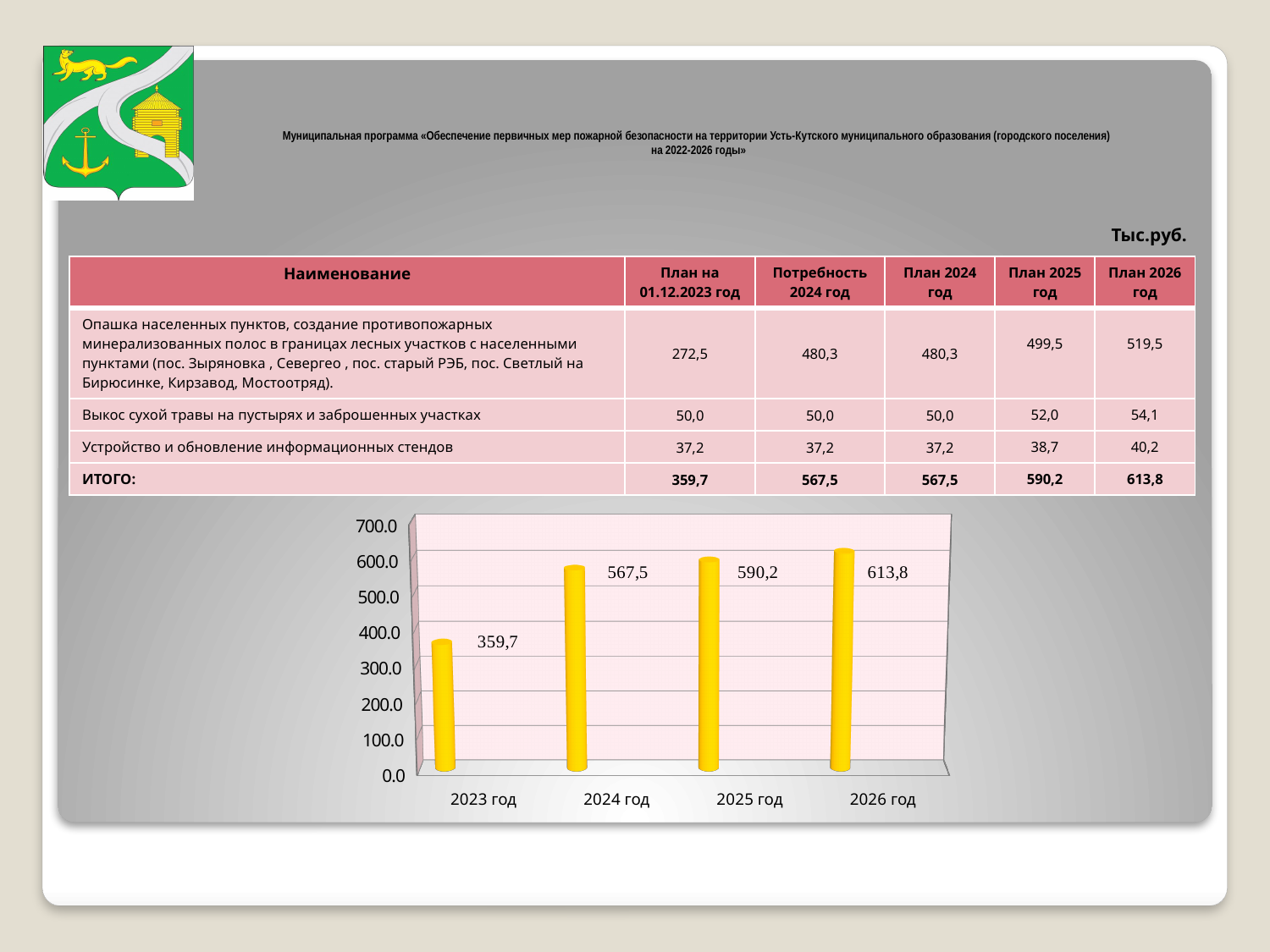
What is the value shown for 2025 год in the chart? 590,2 What is the value shown for 2023 год in the chart? 359,7 Which year has the lowest value in the chart? 2023 год What is the difference between the values for 2026 год and 2023 год in the chart? 254,1 Which year has the highest value in the chart? 2026 год How many years are shown on the x axis of the chart? 4 What kind of chart is shown on the slide? bar chart What is the value shown for 2026 год in the chart? 613,8 Is the value for 2023 год in the chart greater or less than 400.0? less Do the values in the chart rise or fall from 2023 год to 2026 год? rise Which is larger in the chart, the value for 2024 год or the value for 2025 год? 2025 год What is the value shown for 2024 год in the chart? 567,5